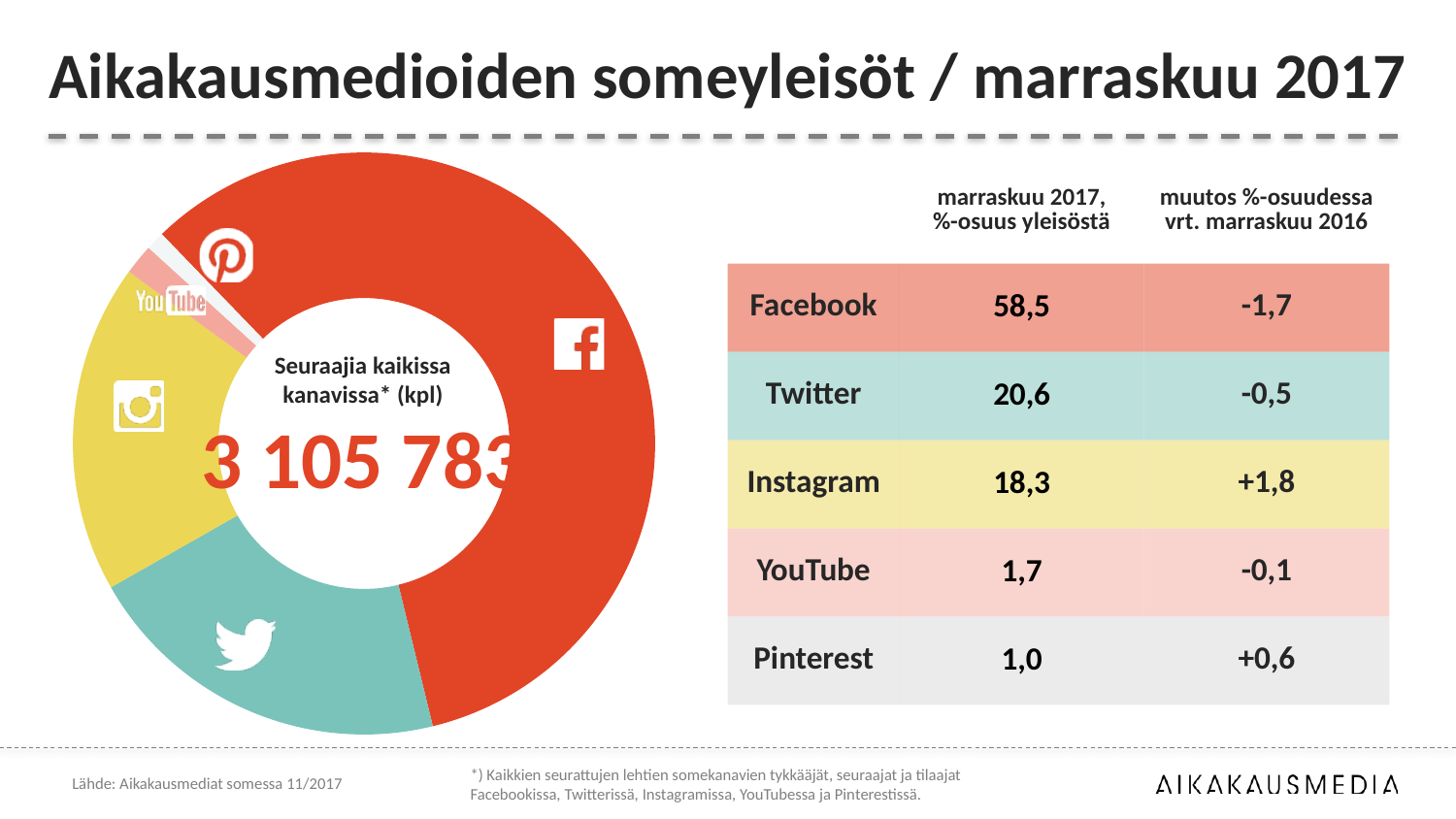
What is the difference in %-share between Facebook and Twitter in November 2017? 37,9 What is the total number of followers across all channels shown in the centre of the donut chart? 3 105 783 Which channel has the smallest share of the audience according to the table? Pinterest Which has a larger %-share of the audience, Twitter or Instagram? Twitter What is the change in %-share for Instagram compared to November 2016? +1,8 How many social media channels are shown as slices in the donut chart? 5 What kind of chart is shown on the left of the slide? Pie chart (donut) What is the change in %-share for Facebook compared to November 2016? -1,7 Which channel has the largest slice in the donut chart? Facebook What is Instagram's %-share of the audience in November 2017? 18,3 Which colour represents Facebook in the donut chart? Red What is Facebook's %-share of the audience in November 2017? 58,5